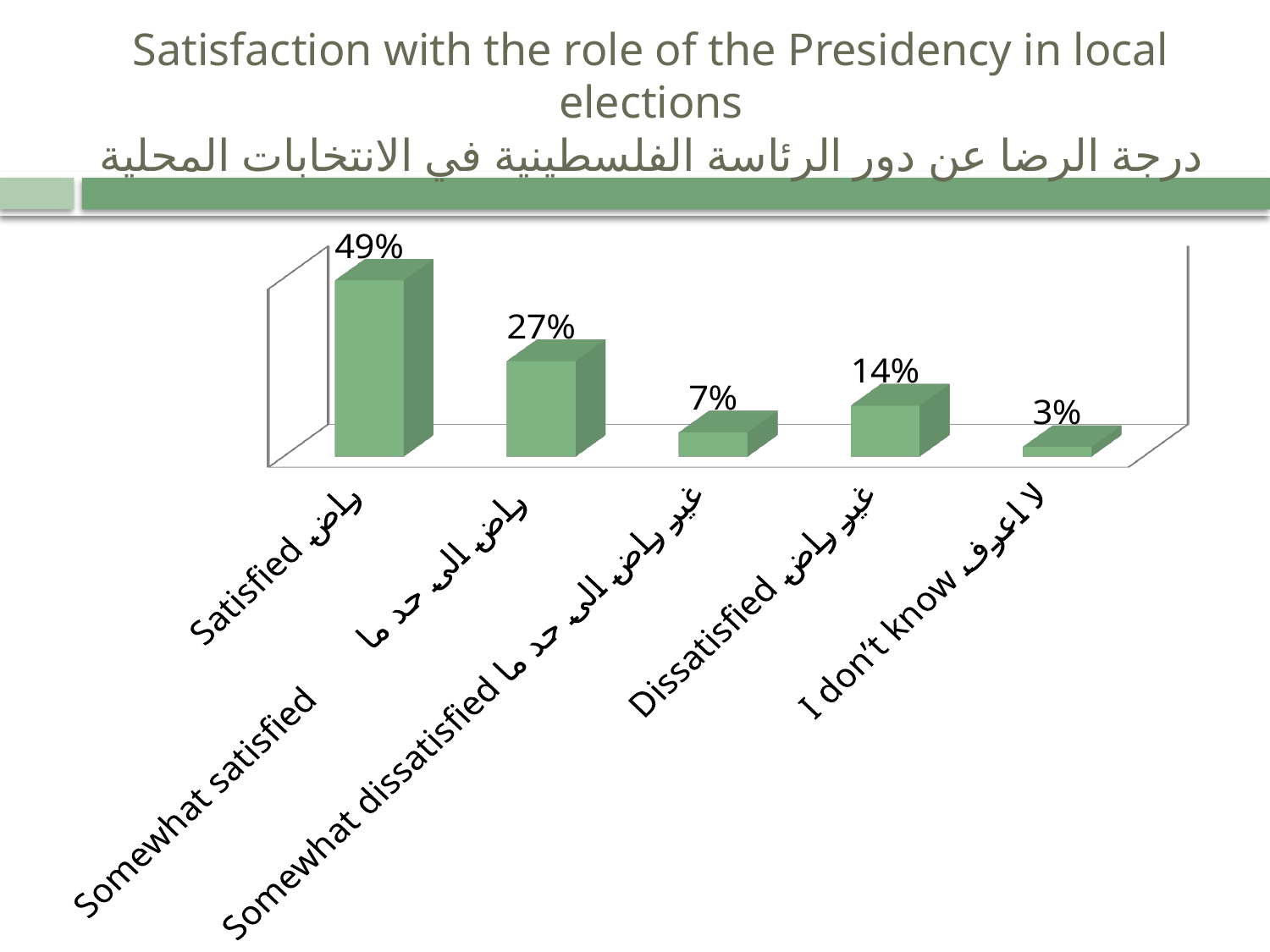
What is the value shown for I don't know? 3% What is the value shown for Dissatisfied? 14% What kind of chart is shown on the slide? Bar chart What is the combined value of Satisfied and Somewhat satisfied? 76% What is the difference between the Satisfied and Somewhat satisfied values? 22% Which category has the lowest value? I don't know What percentage of respondents are Satisfied with the role of the Presidency in local elections? 49% Which is larger, the value for Dissatisfied or the value for Somewhat dissatisfied? Dissatisfied What is the value shown for Somewhat satisfied? 27% What is the value shown for Somewhat dissatisfied? 7% Which category has the highest value? Satisfied How many categories are shown in the chart? 5